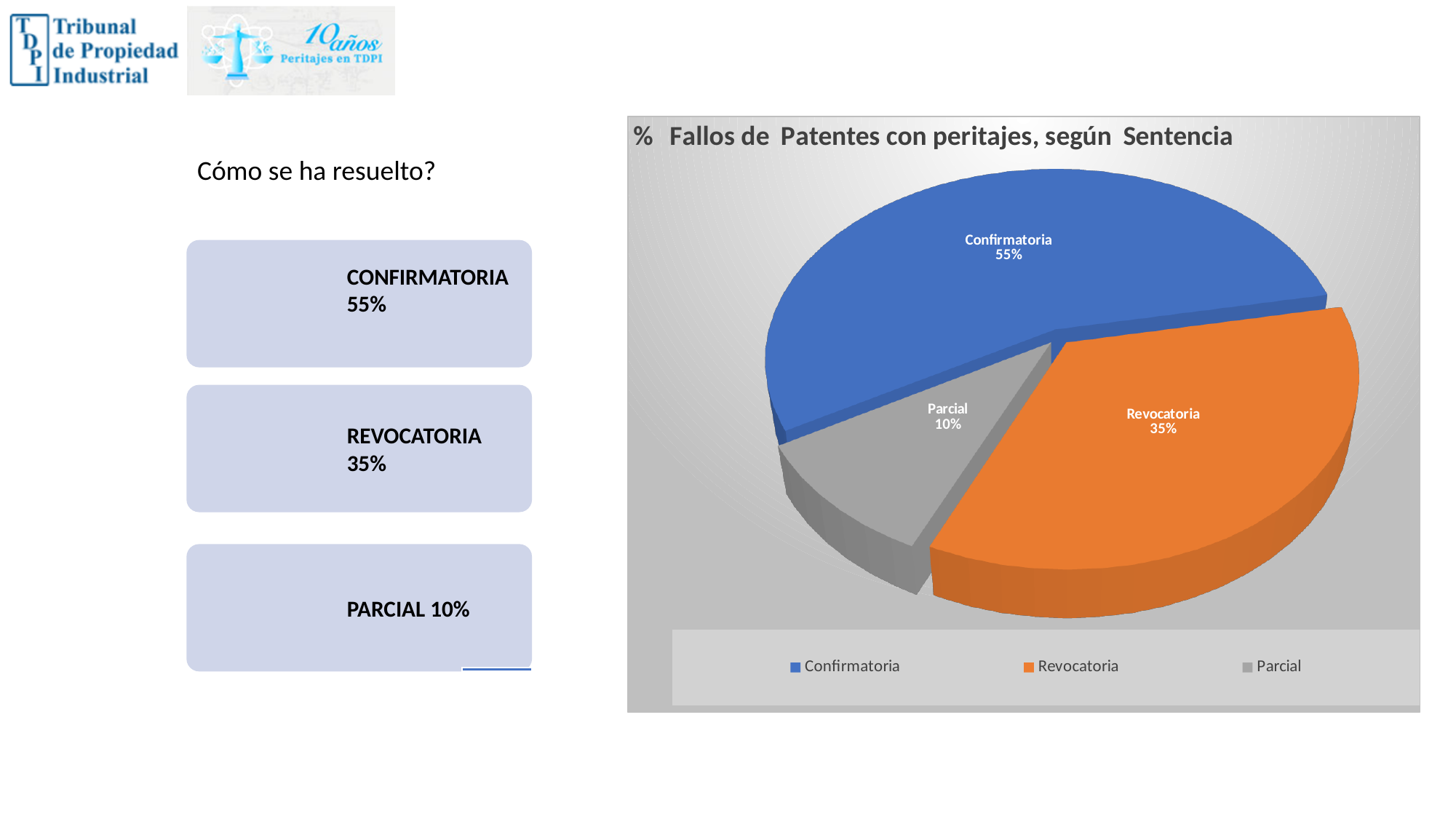
Which category has the largest share of the pie? Confirmatoria What is the difference in percentage points between Revocatoria and Parcial? 25 What is the title of the chart? % Fallos de Patentes con peritajes, según Sentencia Which is larger, Revocatoria or Parcial? Revocatoria What is the difference in percentage points between Confirmatoria and Revocatoria? 20 What type of chart is shown on the slide? Pie chart What percentage of the pie is Parcial? 10% What percentage of the pie is Confirmatoria? 55% What percentage of the pie is Revocatoria? 35% What colour is the Revocatoria slice? Orange How many slices does the pie chart have? 3 Which category has the smallest share of the pie? Parcial